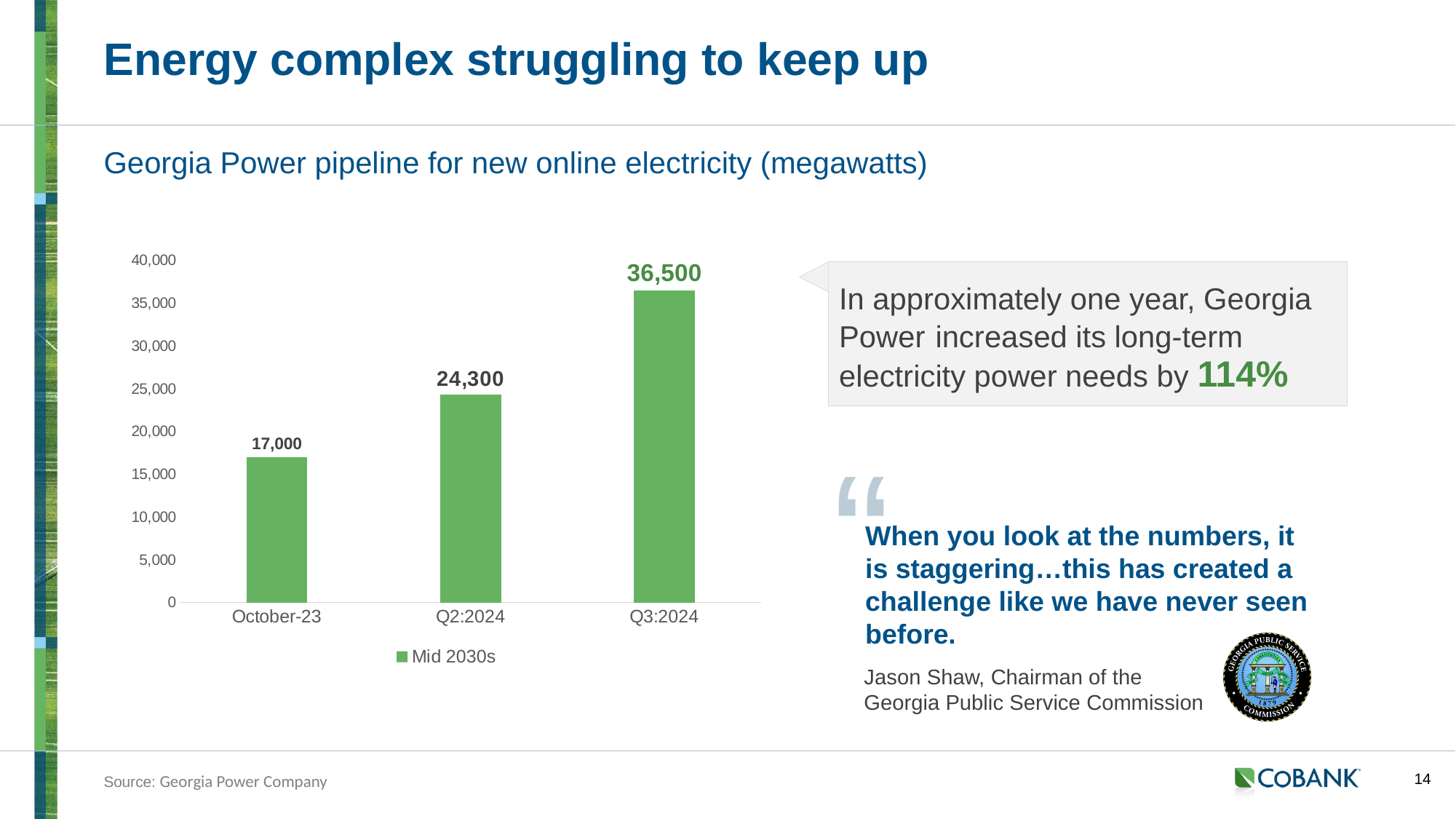
Which category has the highest value? Q3:2024 What is the value for Q2:2024? 24,300 Which category has the lowest value? October-23 What is the value for Q3:2024? 36,500 How many categories are shown on the x axis? 3 What kind of chart is shown on the slide? Bar chart What is the difference between the values for Q3:2024 and October-23? 19,500 What is the value for October-23? 17,000 Do the values rise or fall from October-23 to Q3:2024? Rise How many series does the legend list? 1 What is the difference between the values for Q2:2024 and October-23? 7,300 Which is larger, the value for Q2:2024 or the value for October-23? Q2:2024